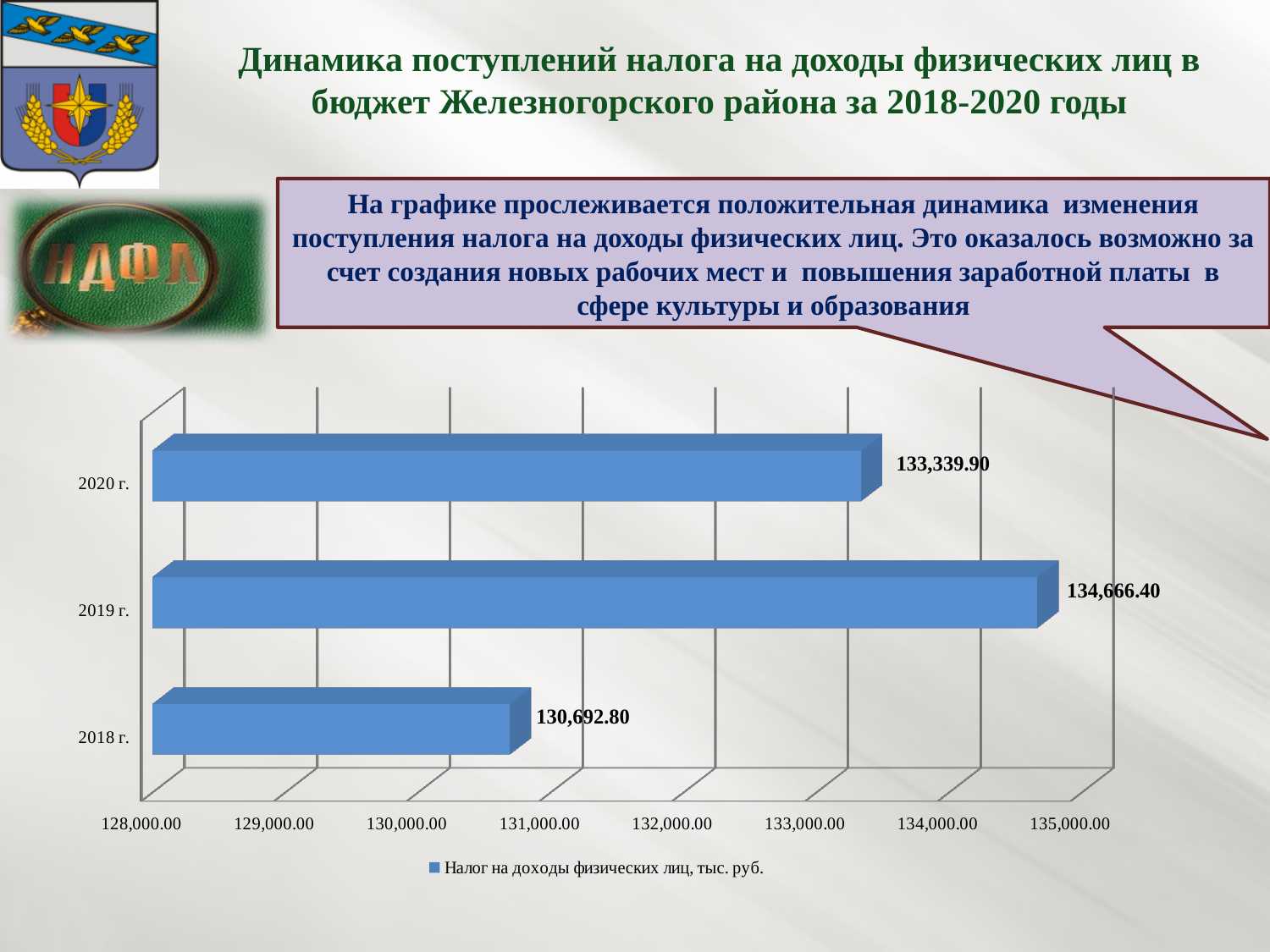
What is the value for 2019 г.? 134,666.40 Which year has the highest value? 2019 г. What kind of chart is shown on the slide? bar chart What is the difference between the values for 2019 г. and 2018 г.? 3,973.60 Is the value for 2018 г. greater or less than 131,000.00? less Which is larger, the value for 2020 г. or the value for 2018 г.? 2020 г. What is the difference between the values for 2019 г. and 2020 г.? 1,326.50 What is the legend entry of the chart? Налог на доходы физических лиц, тыс. руб. What is the value for 2018 г.? 130,692.80 Which year has the lowest value? 2018 г. What is the value for 2020 г.? 133,339.90 How many years are shown in the chart? 3